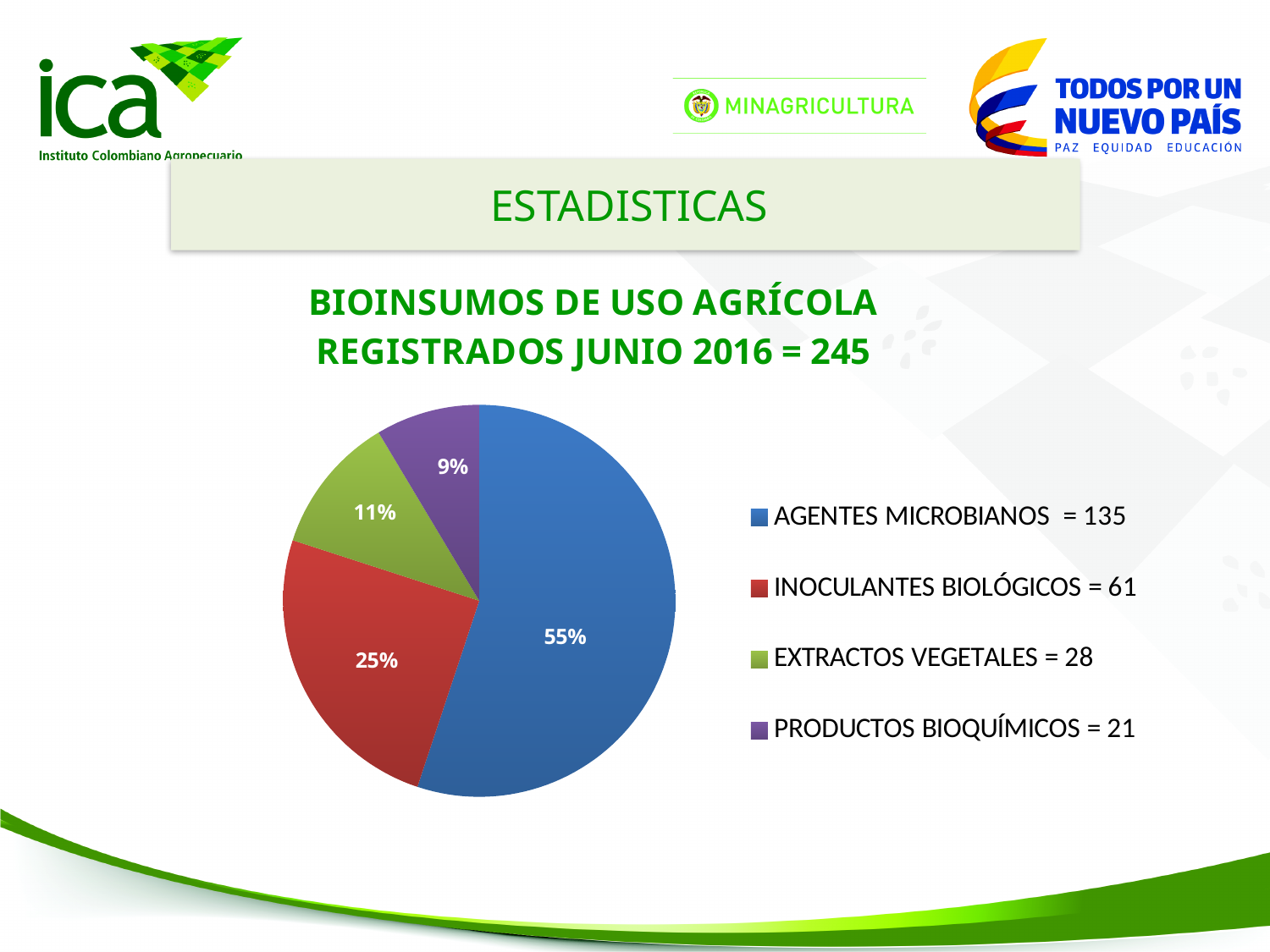
What kind of chart is shown on the slide? pie chart What is the total number of bioinsumos registered as of June 2016, according to the chart title? 245 What percentage share does INOCULANTES BIOLÓGICOS have in the pie chart? 25% What percentage share does PRODUCTOS BIOQUÍMICOS have in the pie chart? 9% Which category has the largest slice of the pie chart? AGENTES MICROBIANOS What is the difference in count between INOCULANTES BIOLÓGICOS and PRODUCTOS BIOQUÍMICOS? 40 According to the legend, how many AGENTES MICROBIANOS are registered? 135 According to the legend, how many EXTRACTOS VEGETALES are registered? 28 What percentage share does EXTRACTOS VEGETALES have in the pie chart? 11% Which category has the smallest slice of the pie chart? PRODUCTOS BIOQUÍMICOS How many categories does the pie chart show? 4